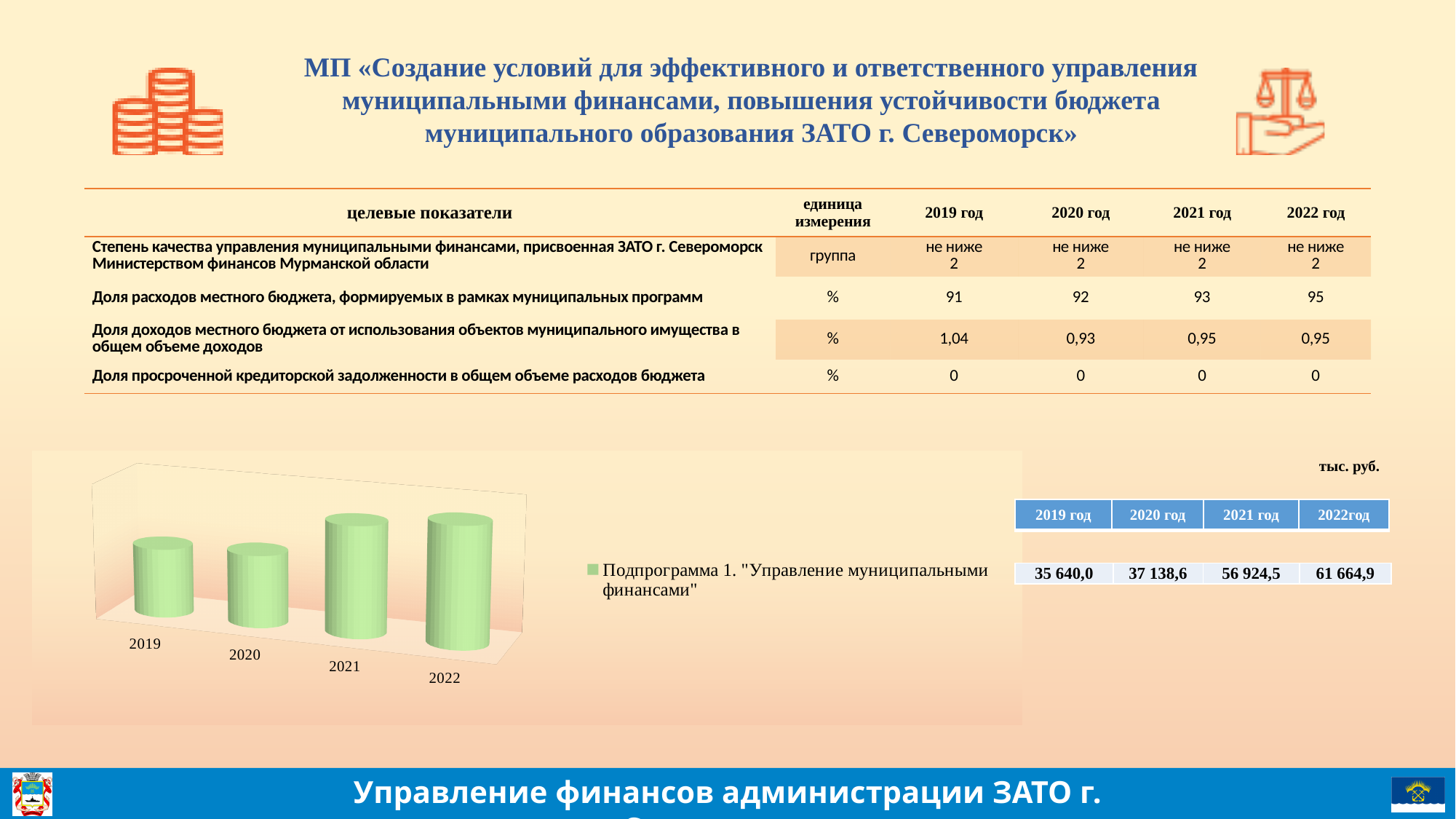
Do the bar values generally rise or fall from 2019 to 2022? rise How many series does the legend of the bar chart list? 1 According to the table next to the chart, what is the value for 2020 for Подпрограмма 1? 37 138,6 According to the table next to the chart, what is the value for 2019 for Подпрограмма 1? 35 640,0 Using the values in the table next to the chart, what is the difference between the 2022 and 2019 values? 26 024,9 How many years (categories) are plotted on the bar chart? 4 What is the name of the series shown in the chart legend? Подпрограмма 1. "Управление муниципальными финансами" What kind of chart is shown at the bottom left of the slide? bar chart According to the table next to the chart, what is the value for 2021 for Подпрограмма 1? 56 924,5 According to the table next to the chart, what is the value for 2022 for Подпрограмма 1? 61 664,9 Which year has the tallest bar in the chart? 2022 Which bar is taller in the chart, 2021 or 2020? 2021